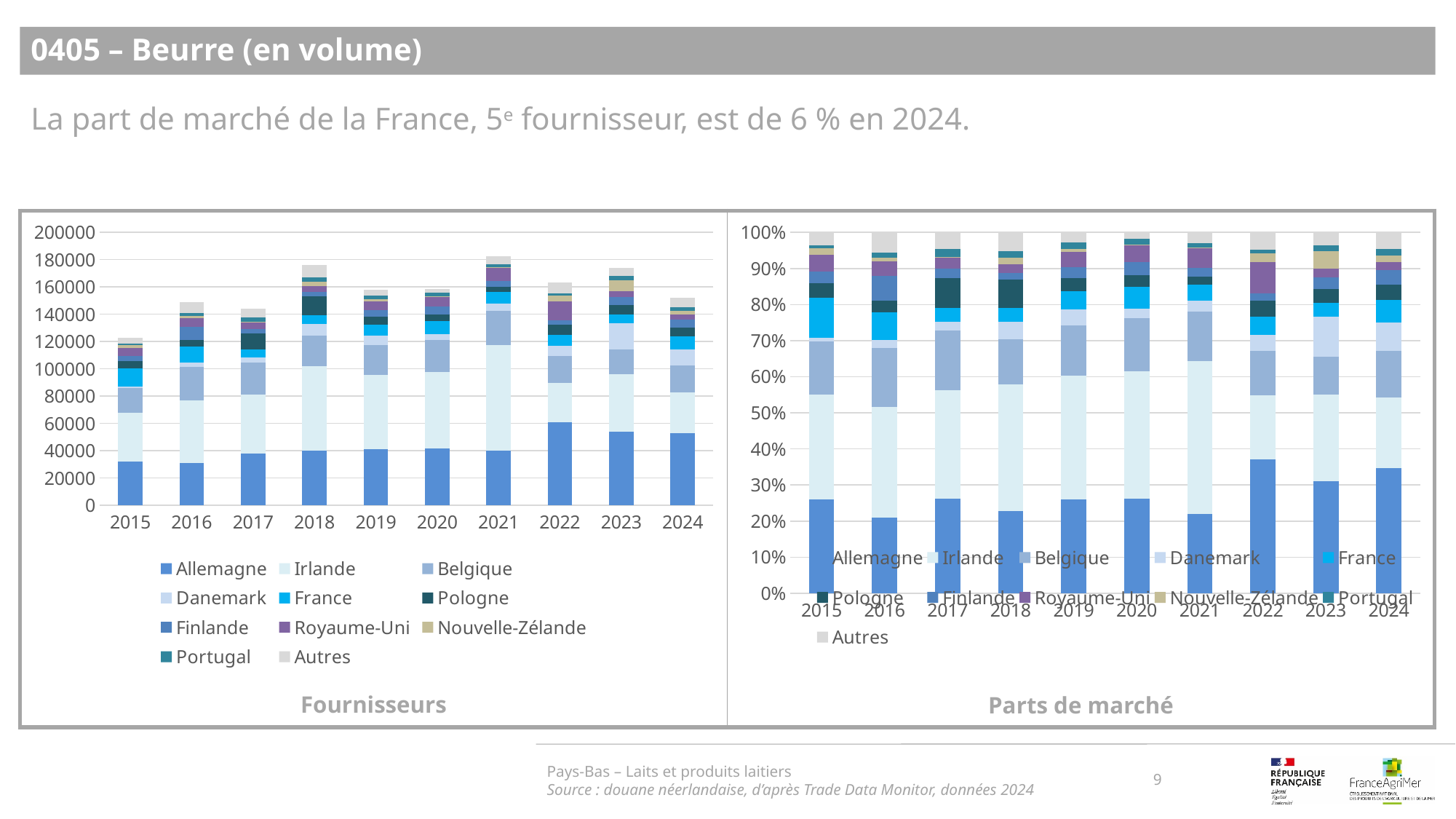
What is the title of the chart on the right of the slide? Parts de marché In the 'Fournisseurs' chart, is the total for 2024 greater or less than 160000? less In the 'Parts de marché' chart, is the Allemagne share for 2024 greater or less than 20%? greater What kind of chart is the 'Fournisseurs' chart on the left? Stacked bar chart In the 'Fournisseurs' chart, is the total for 2018 greater or less than 160000? greater In the 'Fournisseurs' chart, which is larger: the Allemagne value for 2022 or for 2015? 2022 How many years are shown on the x axis of the 'Parts de marché' chart? 10 In the 'Fournisseurs' chart, which year has the lowest total bar? 2015 How many series does the legend of the 'Fournisseurs' chart list? 11